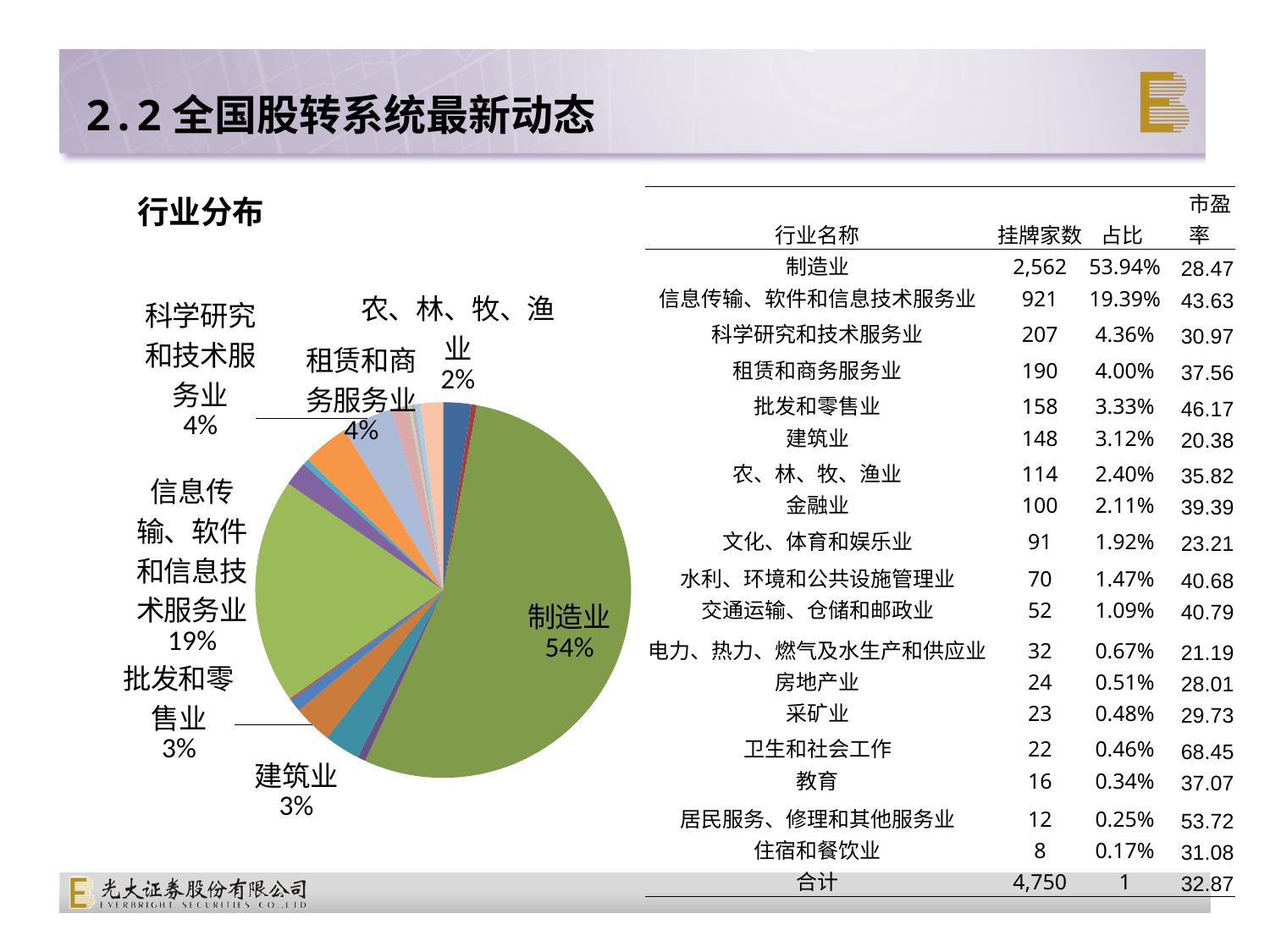
What percentage is shown for 科学研究和技术服务业 in the pie chart? 4% What percentage is shown for 建筑业 in the pie chart? 3% By how many percentage points does the 制造业 slice exceed the 信息传输、软件和信息技术服务业 slice in the pie chart? 35% What is the title shown above the pie chart? 行业分布 What share of the pie chart does 制造业 account for? 54% What percentage is shown for 信息传输、软件和信息技术服务业 in the pie chart? 19% What percentage is shown for 批发和零售业 in the pie chart? 3% Which industry has the largest slice in the pie chart? 制造业 What type of chart is shown under the heading 行业分布? pie chart What percentage is shown for 租赁和商务服务业 in the pie chart? 4% Which slice is larger in the pie chart, 信息传输、软件和信息技术服务业 or 建筑业? 信息传输、软件和信息技术服务业 What percentage is shown for 农、林、牧、渔业 in the pie chart? 2%